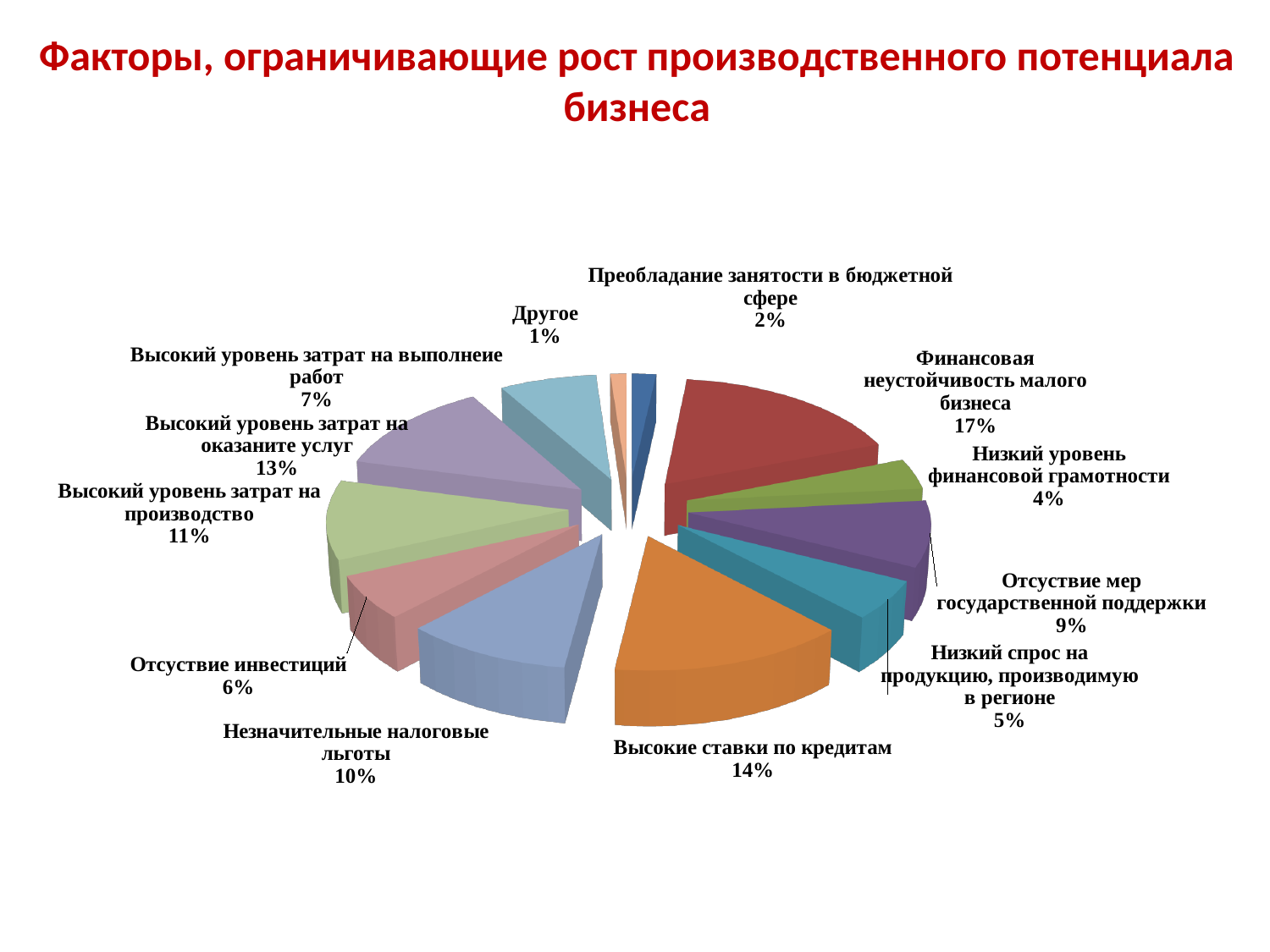
What kind of chart is shown on the slide? Pie chart What percentage is shown for "Отсуствие инвестиций"? 6% What percentage is shown for "Высокие ставки по кредитам"? 14% Which factor has the smallest share of the pie? Другое What is the difference between the shares for "Финансовая неустойчивость малого бизнеса" and "Высокие ставки по кредитам"? 3% How many slices does the pie chart have? 12 What is the title of the slide containing the pie chart? Факторы, ограничивающие рост производственного потенциала бизнеса Which factor has the largest share of the pie? Финансовая неустойчивость малого бизнеса What percentage is shown for "Высокий уровень затрат на оказаните услуг"? 13% What is the combined share of "Отсуствие мер государственной поддержки" and "Низкий спрос на продукцию, производимую в регионе"? 14% Which has a larger share: "Незначительные налоговые льготы" or "Высокий уровень затрат на производство"? Высокий уровень затрат на производство What share of the pie is labelled "Финансовая неустойчивость малого бизнеса"? 17%